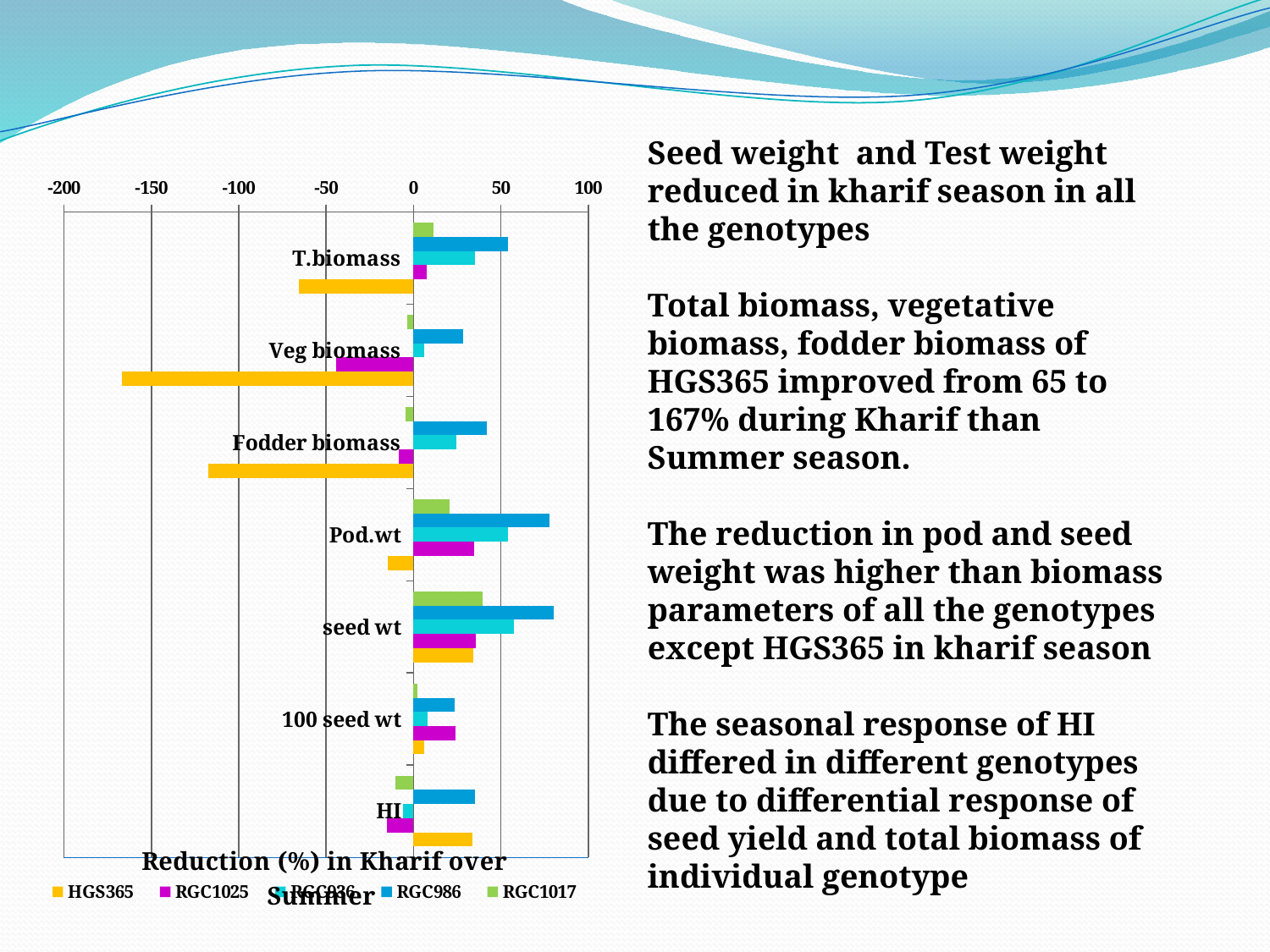
Is the value for HGS365 in T.biomass greater or less than -50? less What is the title of the horizontal axis of the chart? Reduction (%) in Kharif over Summer Is the value for HGS365 in Fodder biomass greater or less than -100? less How many categories are plotted on the chart? 7 In the Pod.wt category, which is larger: the value for RGC986 or the value for HGS365? RGC986 Which category has the lowest value for HGS365? Veg biomass Is the value for RGC1017 in Pod.wt greater or less than 50? less How many series does the chart legend list? 5 Which series has the lowest value in the Veg biomass category? HGS365 What kind of chart is shown on the slide? bar chart